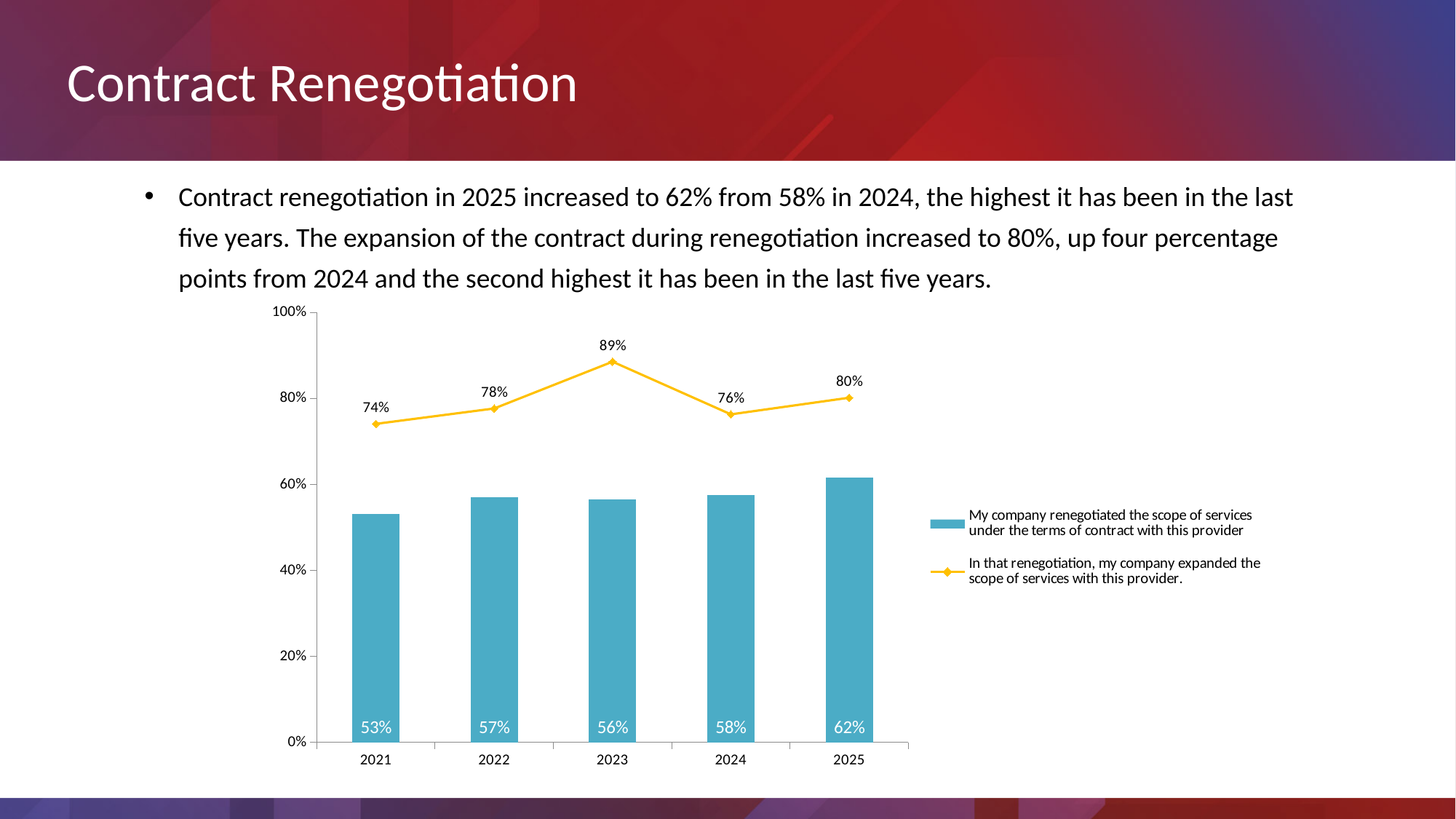
Which is larger: the renegotiation value in 2022 or in 2023? 2022 What percentage of companies renegotiated the scope of services in 2021? 53% What is the value for 'In that renegotiation, my company expanded the scope of services with this provider' in 2023? 89% How many years are shown on the x axis of the chart? 5 What kind of chart is used to show the 'My company renegotiated the scope of services' series? Bar chart In which year was the share of companies that expanded the scope of services during renegotiation highest? 2023 What percentage of companies renegotiated the scope of services in 2025? 62% In which year was the share of companies that renegotiated the scope of services lowest? 2021 How many series does the chart legend list? 2 What is the difference between the expanded-scope value in 2023 and in 2024? 13 percentage points By how many percentage points did the share of companies renegotiating the scope of services change from 2024 to 2025? 4 percentage points What colour is the line for 'In that renegotiation, my company expanded the scope of services with this provider'? Yellow